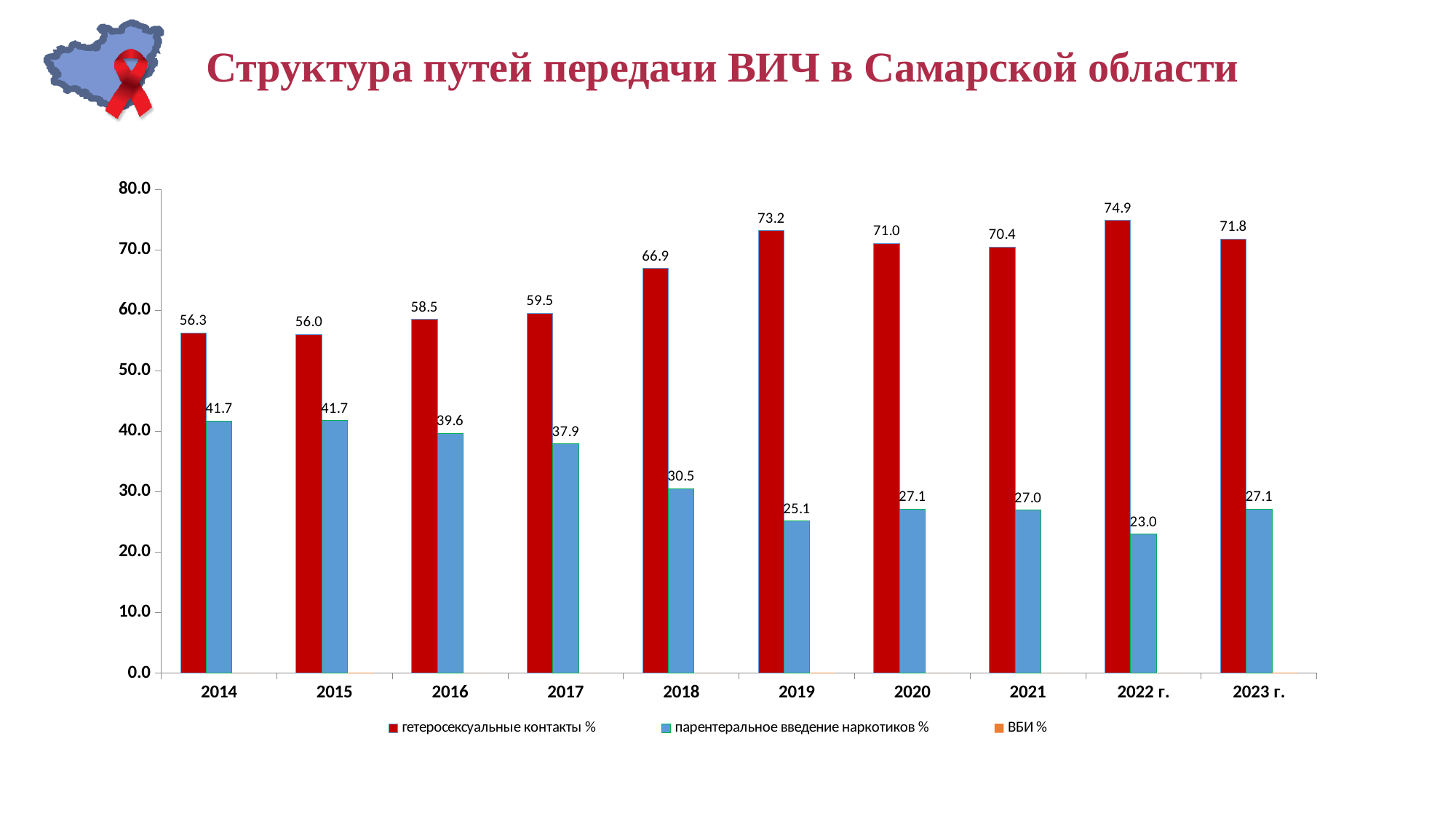
What kind of chart is shown on the slide? bar chart What is the value for парентеральное введение наркотиков % in 2018? 30.5 What is the difference between гетеросексуальные контакты % and парентеральное введение наркотиков % in 2014? 14.6 Is the value for гетеросексуальные контакты % in 2017 greater or less than 60.0? less What is the value for гетеросексуальные контакты % in 2019? 73.2 What is the title of the chart? Структура путей передачи ВИЧ в Самарской области How many years are shown on the x axis? 10 Which is larger in 2021: гетеросексуальные контакты % or парентеральное введение наркотиков %? гетеросексуальные контакты % In which year is the value for парентеральное введение наркотиков % the lowest? 2022 г. How many series does the legend list? 3 Does the value for парентеральное введение наркотиков % rise or fall from 2014 to 2019? fall In which year is the value for гетеросексуальные контакты % the highest? 2022 г.